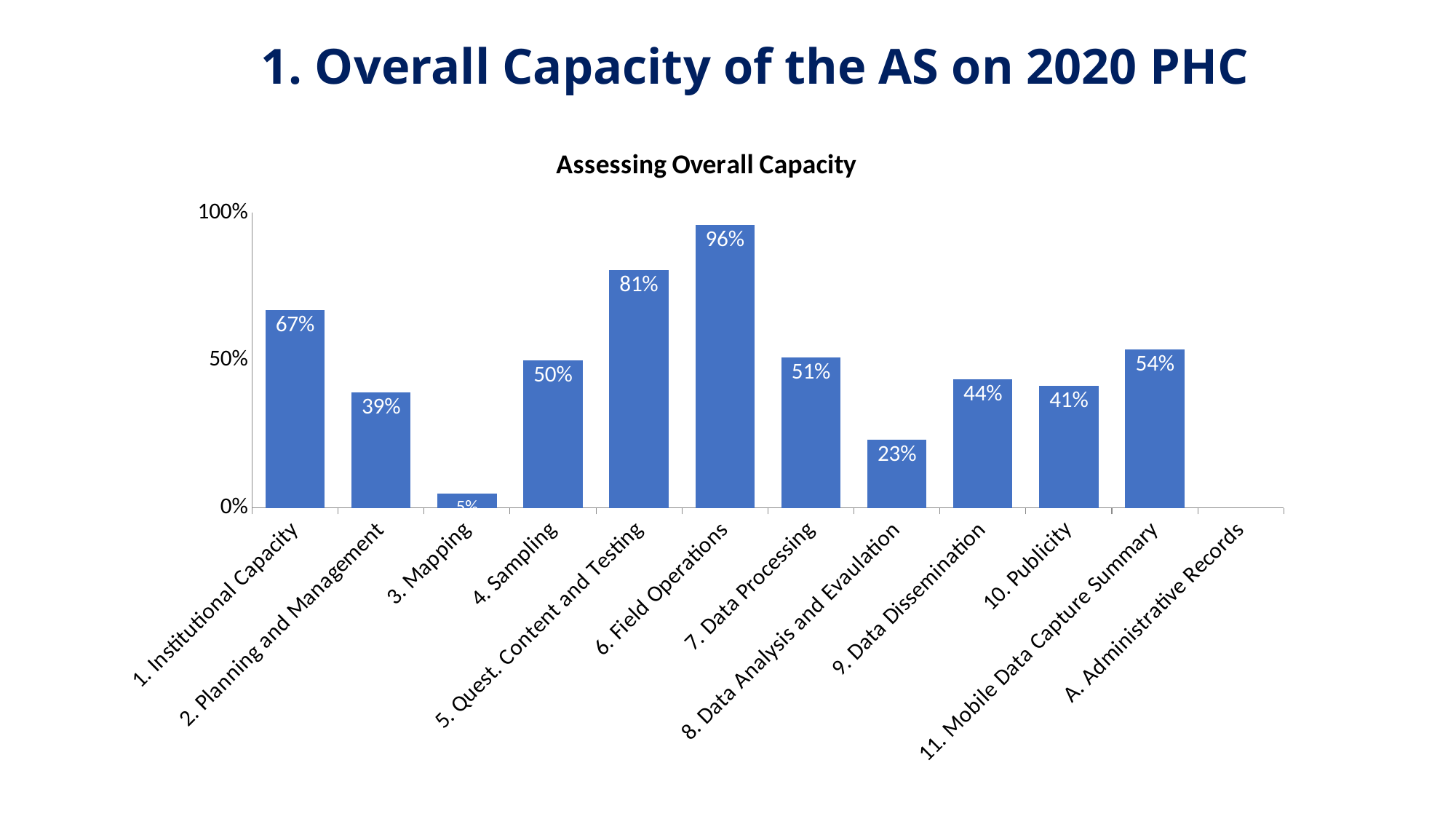
What is the title of the chart? Assessing Overall Capacity What is the value for 2. Planning and Management? 39% Which is larger, the value for 9. Data Dissemination or the value for 10. Publicity? 9. Data Dissemination What is the value for 6. Field Operations? 96% What is the difference between the values for 5. Quest. Content and Testing and 1. Institutional Capacity? 14% What is the value for 8. Data Analysis and Evaluation? 23% What type of chart is shown on the slide? Bar chart Is the value for 7. Data Processing greater or less than 50%? greater Which category has the highest value? 6. Field Operations What is the value for 11. Mobile Data Capture Summary? 54% What is the difference between the values for 4. Sampling and 3. Mapping? 45% How many categories are labelled on the x axis? 12